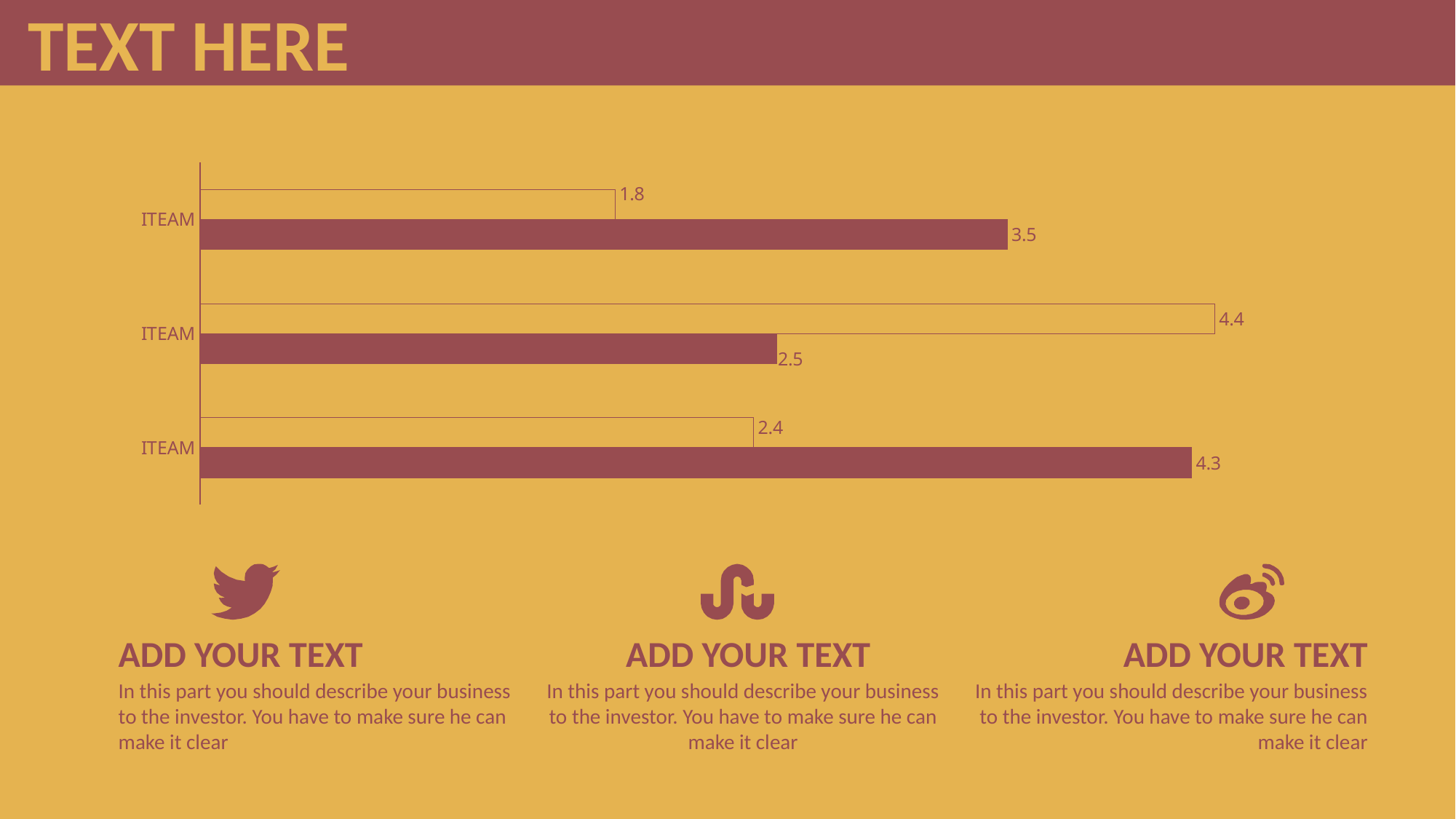
How many bars are drawn for each category on the chart? 2 What is the value of the filled (solid) bar for the bottom ITEAM category? 4.3 Which bar on the chart has the highest value? the outlined bar of the middle ITEAM category (4.4) How many categories are plotted on the chart? 3 What is the value of the filled (solid) bar for the top ITEAM category? 3.5 For the middle ITEAM category, which is larger: the outlined bar or the filled bar? the outlined bar What kind of chart is shown on the slide? bar chart Which bar on the chart has the lowest value? the outlined bar of the top ITEAM category (1.8) What is the difference between the filled bar and the outlined bar for the top ITEAM category? 1.7 What is the difference between the filled bar (4.3) and the outlined bar (2.4) for the bottom ITEAM category? 1.9 What is the value of the outlined bar for the top ITEAM category? 1.8 What is the value of the outlined bar for the middle ITEAM category? 4.4